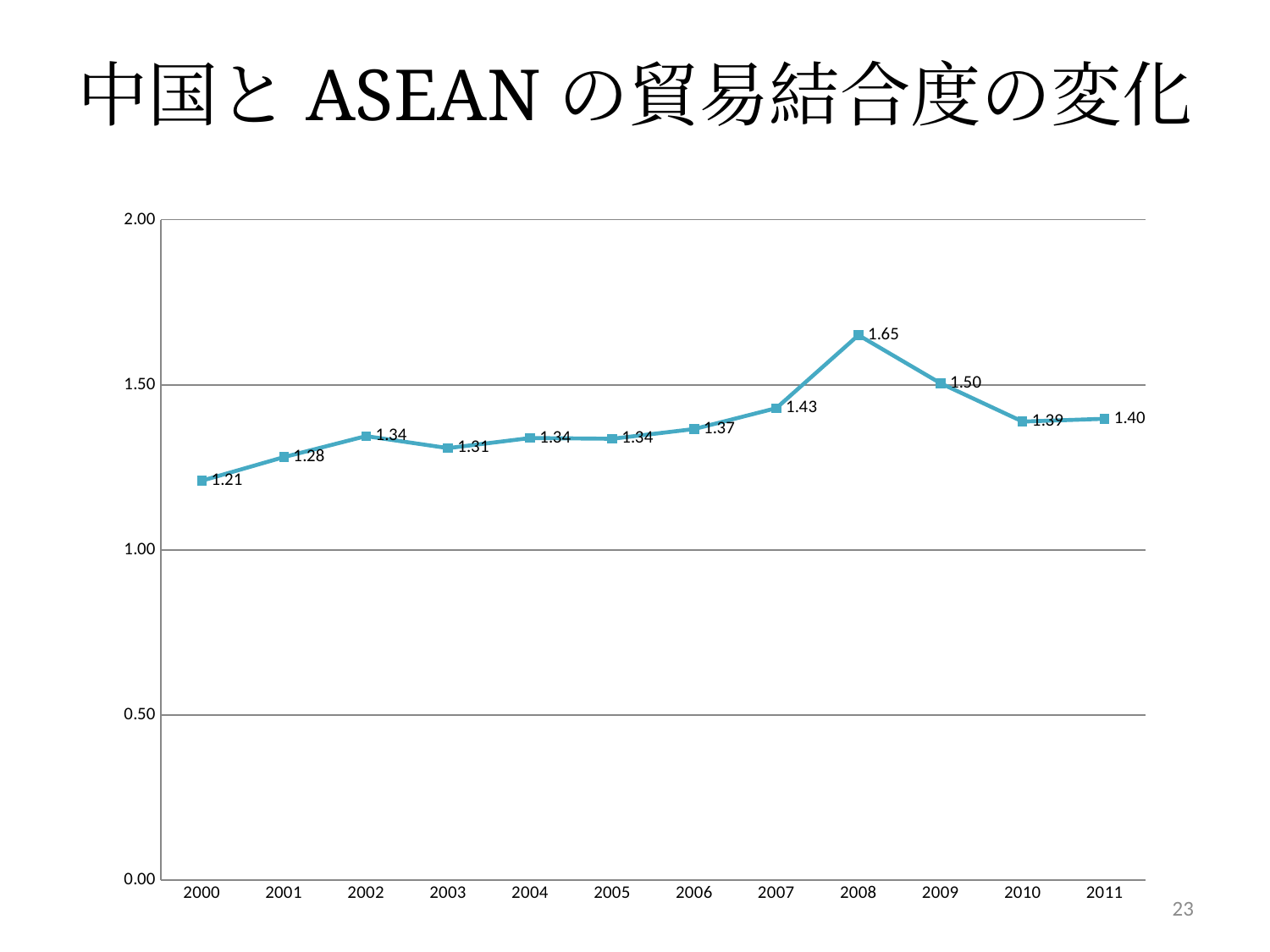
What kind of chart is shown on the slide? line chart What is the value for 2008? 1.65 What is the difference between the values for 2011 and 2000? 0.19 How many years are plotted on the chart? 12 What is the difference between the values for 2008 and 2009? 0.15 What is the value for 2000? 1.21 Which year has the lowest value? 2000 What is the value for 2011? 1.40 Is the value for 2009 greater or less than 1.00? greater Which is larger, the value for 2007 or the value for 2010? 2007 Which year has the highest value? 2008 Does the value rise or fall from 2000 to 2002? rise